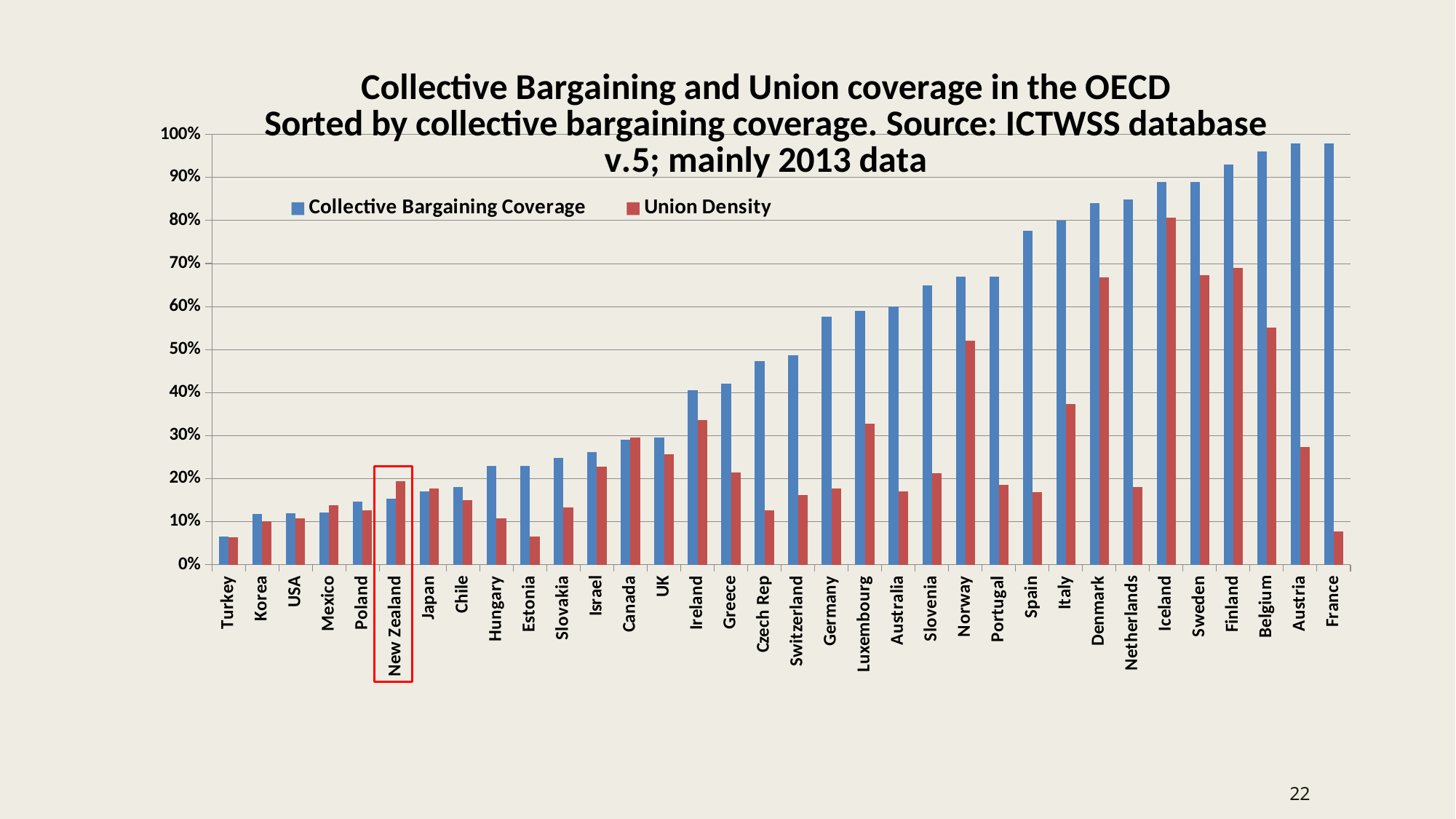
Do the Collective Bargaining Coverage values rise or fall from left to right along the x axis? rise What kind of chart is shown on the slide? bar chart How many series does the legend list? 2 Is the Union Density value for France greater or less than 10%? less Is the Collective Bargaining Coverage value for Germany greater or less than 50%? greater Which country has the lowest Collective Bargaining Coverage? Turkey Is the Union Density value for Denmark greater or less than 60%? greater Which is larger: Union Density for Norway or Union Density for Italy? Norway Which country has the highest Union Density? Iceland Which country is highlighted with a red box on the x axis? New Zealand How many countries are shown on the x axis? 34